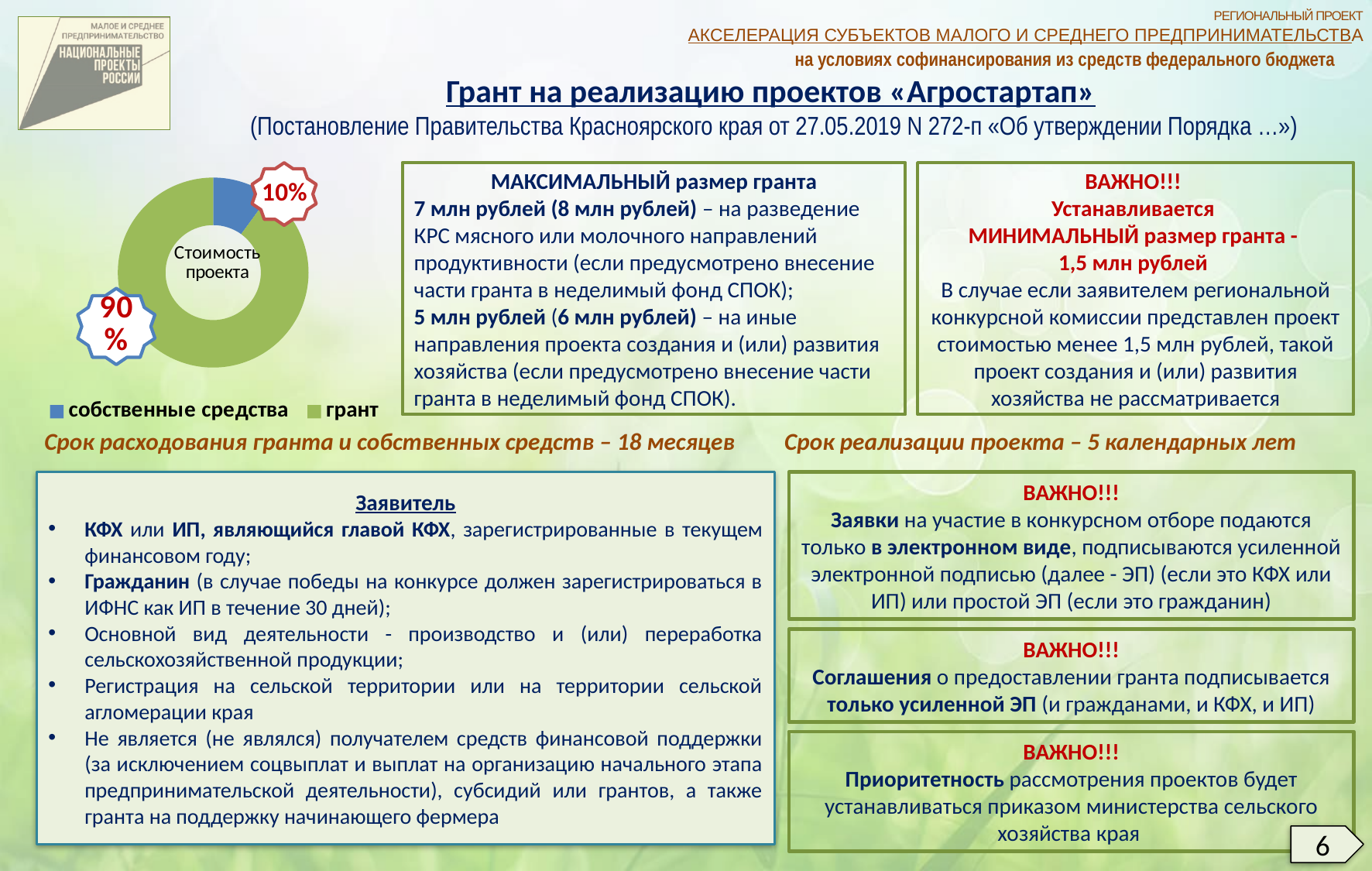
What text is shown in the centre of the doughnut chart? Стоимость проекта What share of the project cost does the "грант" slice represent? 90% What share of the project cost does the "собственные средства" slice represent? 10% What kind of chart is shown on the slide? doughnut chart What is the difference in percentage points between the "грант" share and the "собственные средства" share? 80% How many entries does the chart legend list? 2 How many slices does the chart have? 2 Which is larger, the share for "грант" or the share for "собственные средства"? грант Which slice of the chart is the smallest? собственные средства What colour is the "грант" slice in the chart? green Which slice of the chart is the largest? грант